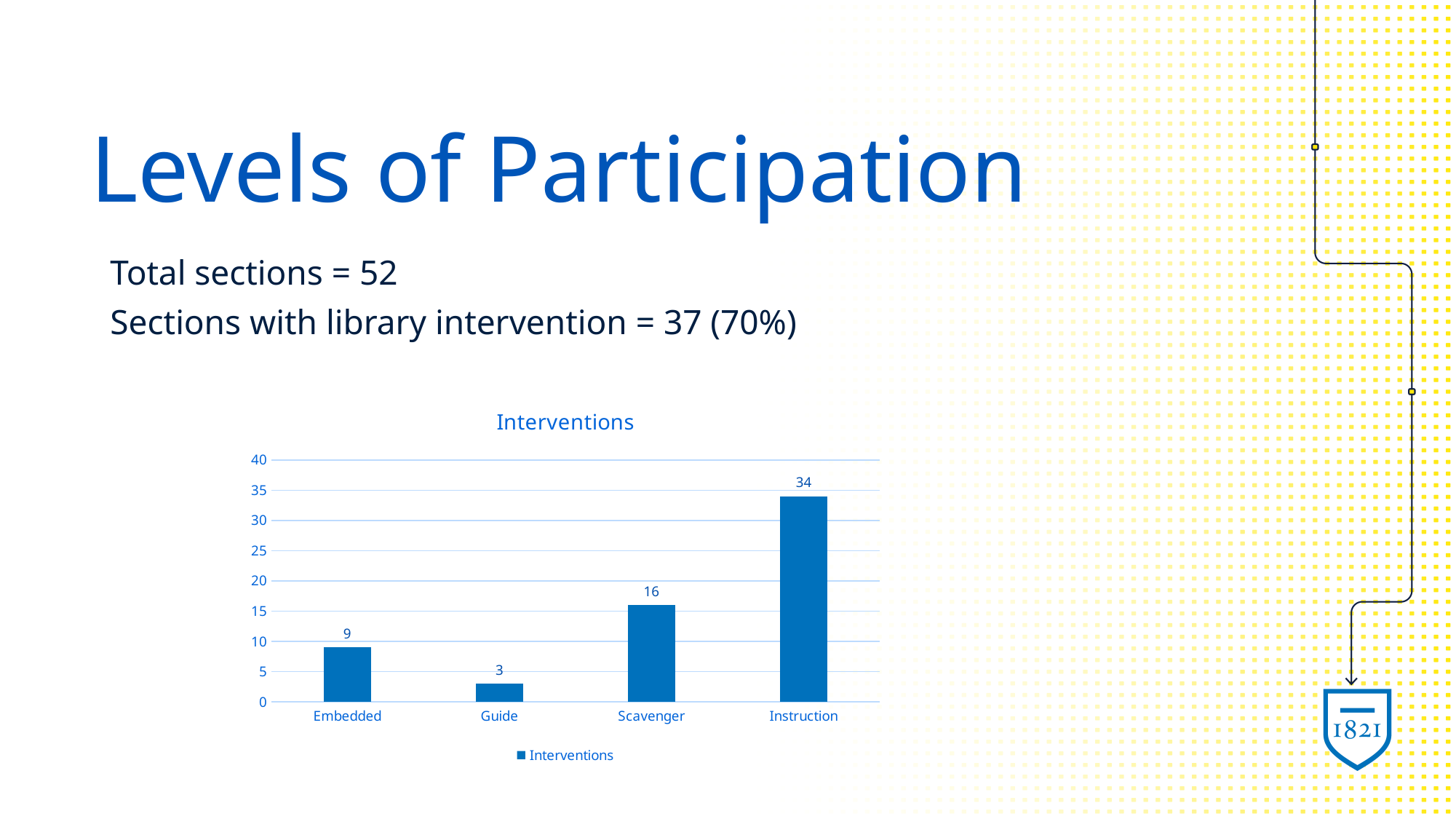
Which is larger, the value for Embedded or the value for Guide? Embedded What is the title of the chart on the slide? Interventions What is the difference between the values for Instruction and Scavenger? 18 How many categories are shown on the x axis of the Interventions chart? 4 What is the value for Embedded in the Interventions chart? 9 Is the value for Scavenger greater or less than 20? less What is the value for Guide in the Interventions chart? 3 What is the value for Scavenger in the Interventions chart? 16 What is the value for Instruction in the Interventions chart? 34 Which category has the lowest value in the Interventions chart? Guide What kind of chart is shown on the slide? bar chart Which category has the highest value in the Interventions chart? Instruction